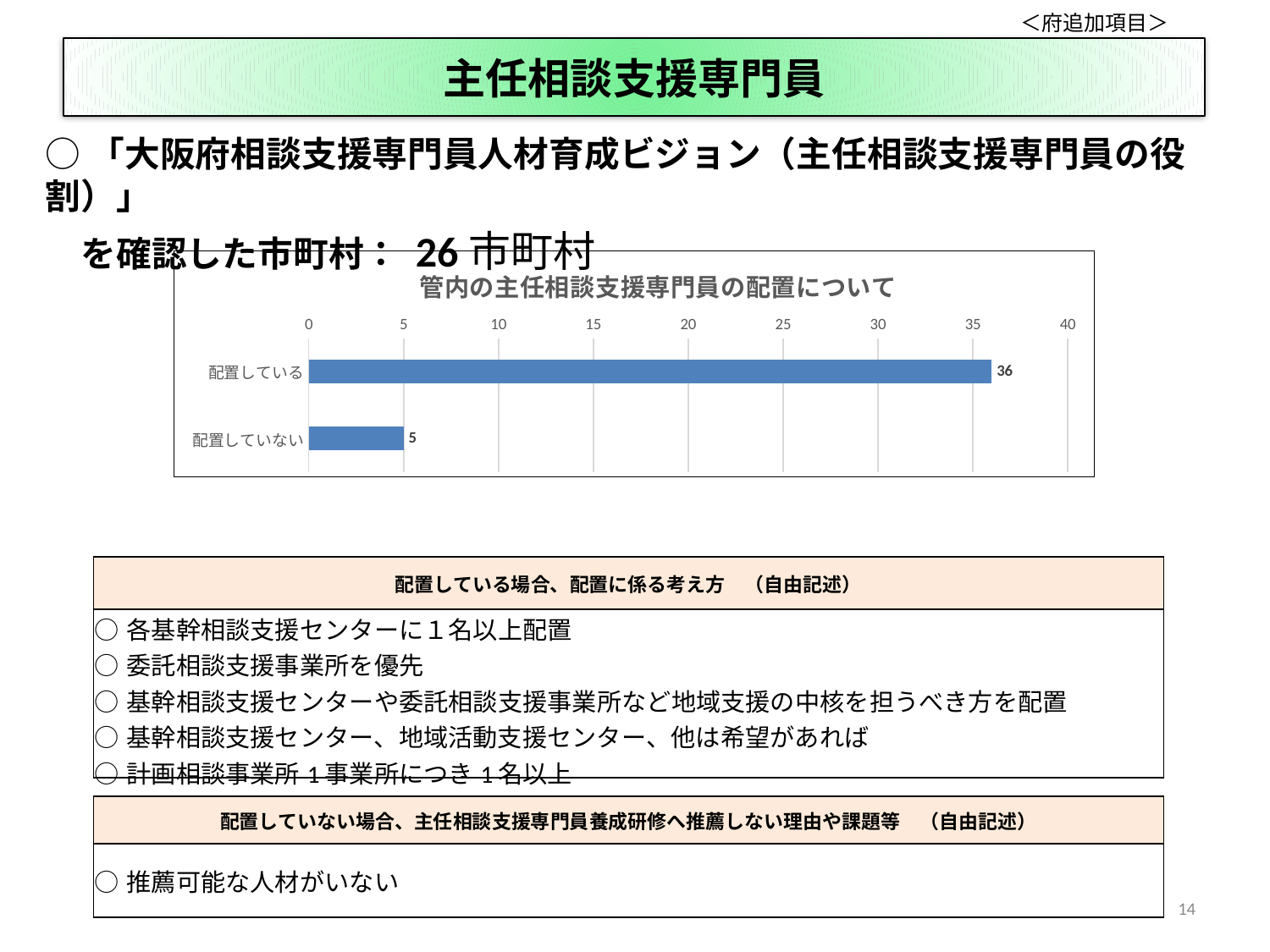
What is the value for 配置している in the chart? 36 Is the value for 配置していない greater or less than 10? less What is the maximum value shown on the chart's axis? 40 Which category has the highest value in the chart? 配置している How many categories are shown in the chart? 2 What kind of chart is shown on the slide? bar chart Which is larger, the value for 配置している or the value for 配置していない? 配置している What is the difference between the values for 配置している and 配置していない? 31 Which category has the lowest value in the chart? 配置していない What is the title of the chart? 管内の主任相談支援専門員の配置について Is the value for 配置している greater or less than 30? greater What is the value for 配置していない in the chart? 5